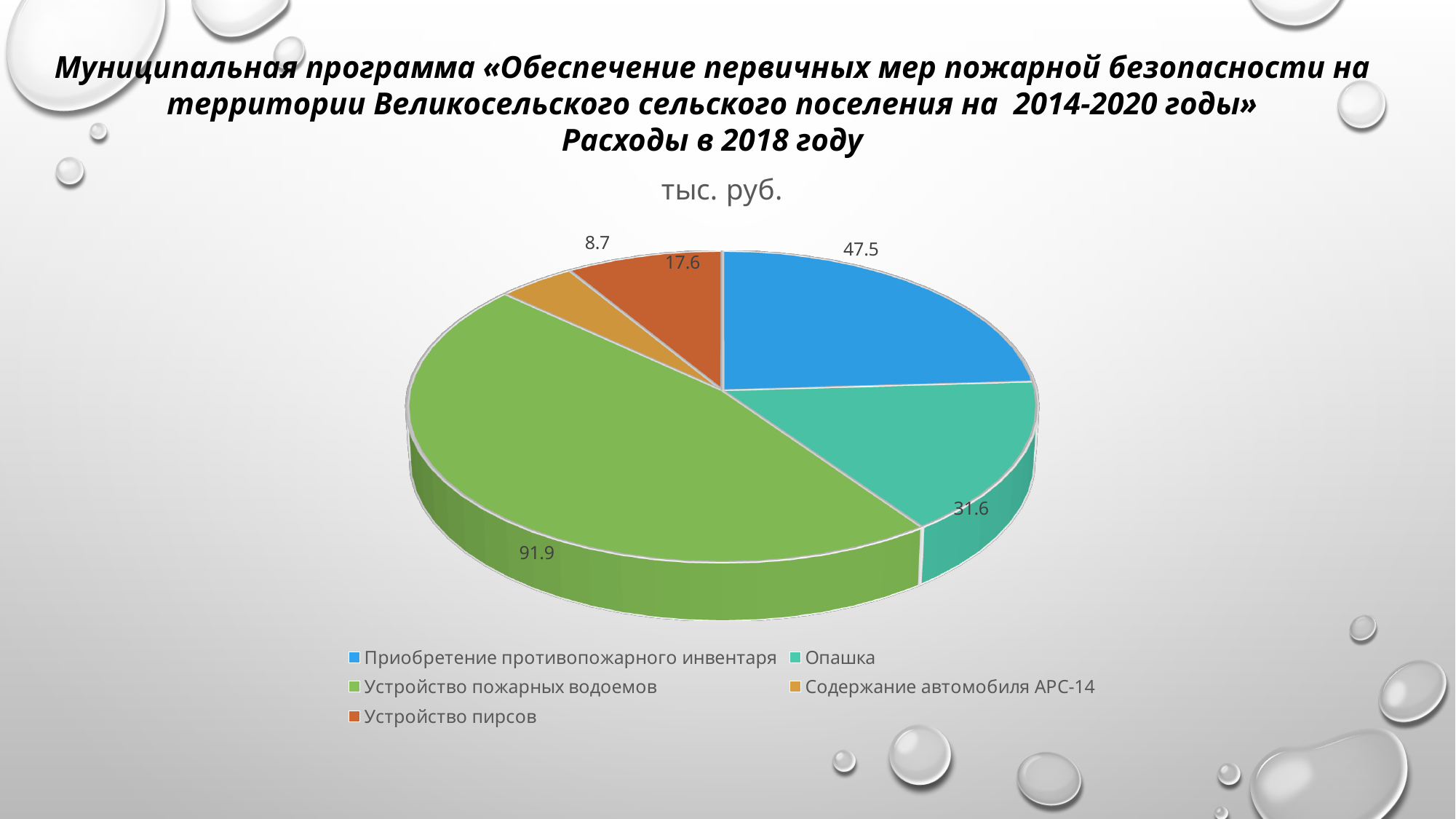
What is the value for Приобретение противопожарного инвентаря? 47.5 Which category has the largest slice of the pie? Устройство пожарных водоемов Which category has the smallest slice of the pie? Содержание автомобиля АРС-14 How many categories does the pie chart show? 5 What is the value for Опашка? 31.6 What is the title of the chart? тыс. руб. What is the value for Содержание автомобиля АРС-14? 8.7 What type of chart is shown on the slide? Pie chart What is the difference between the values for Устройство пожарных водоемов and Приобретение противопожарного инвентаря? 44.4 What is the value for Устройство пирсов? 17.6 Which is larger, the value for Опашка or the value for Устройство пирсов? Опашка What is the value for Устройство пожарных водоемов? 91.9